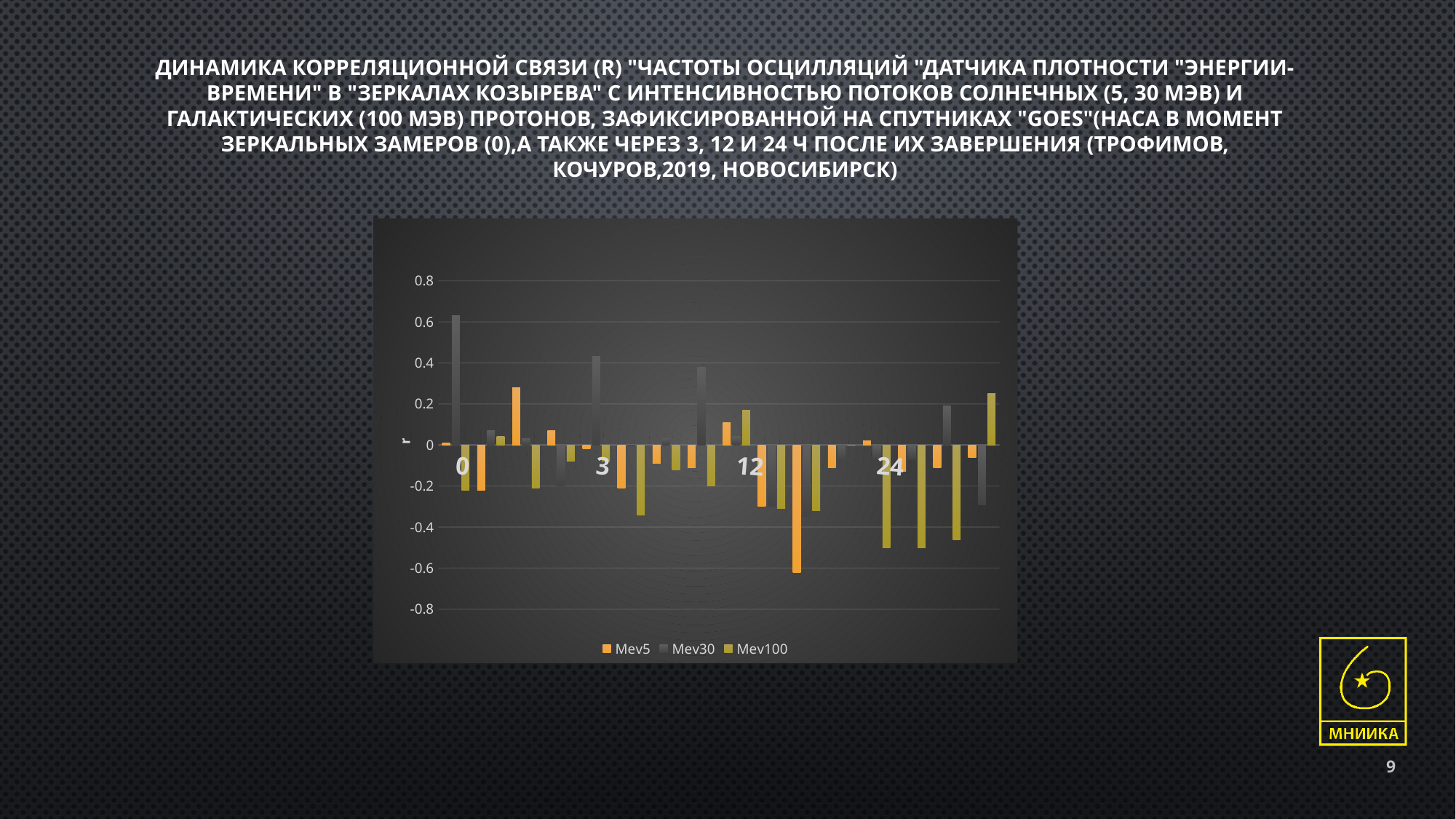
How many series does the chart legend list? 3 What is the lowest value shown on the vertical axis of the chart? -0.8 Is the lowest Mev5 bar, located just right of the 12 label, greater or less than -0.4? less Is the tallest Mev30 bar, at the left of the chart near the 0 label, greater or less than 0.4? greater Which series has the single lowest (most negative) bar in the chart? Mev5 What is the label on the vertical axis of the chart? r What kind of chart is shown on the slide? bar chart What is the highest value shown on the vertical axis of the chart? 0.8 Which series has the single tallest positive bar in the chart? Mev30 How many time labels (hours) are shown along the x axis of the chart? 4 What are the time labels shown along the x axis of the chart? 0, 3, 12, 24 What are the names of the series listed in the chart legend? Mev5, Mev30, Mev100